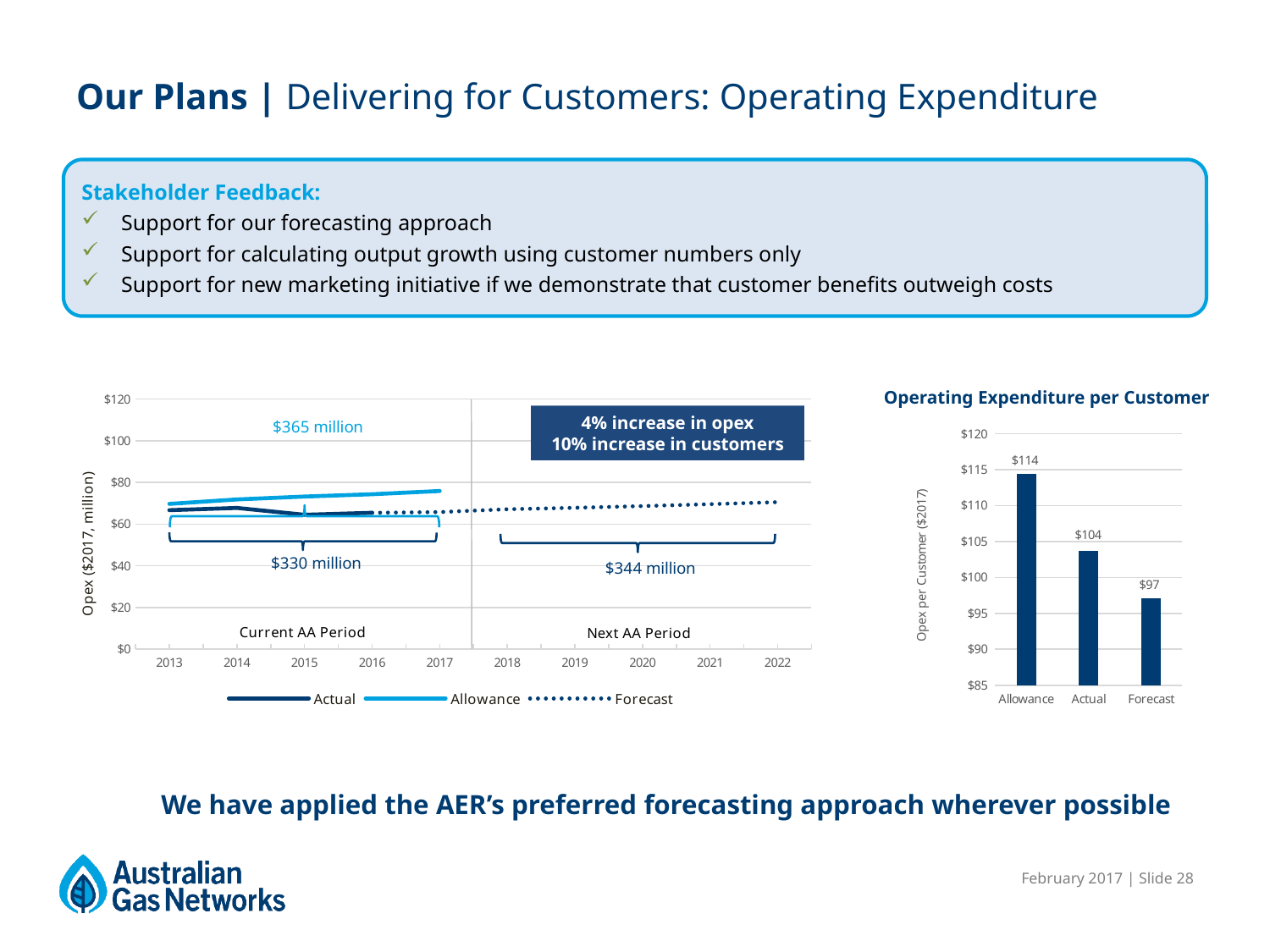
In the Operating Expenditure per Customer chart, what is the value for Allowance? $114 How many series does the legend of the left-hand Opex chart list? 3 In the Operating Expenditure per Customer chart, which is larger, Actual or Forecast? Actual In the left-hand Opex chart, what total is annotated for the Next AA Period forecast? $344 million In the Operating Expenditure per Customer chart, which category has the highest value? Allowance In the Operating Expenditure per Customer chart, which category has the lowest value? Forecast In the Operating Expenditure per Customer chart, what is the difference between the Allowance and Actual values? $10 In the Operating Expenditure per Customer chart, what is the value for Actual? $104 In the Operating Expenditure per Customer chart, what is the value for Forecast? $97 In the left-hand Opex chart, is the Allowance value for 2017 greater or less than $60? greater How many bars are shown in the Operating Expenditure per Customer chart? 3 What kind of chart is the Operating Expenditure per Customer chart? Bar chart